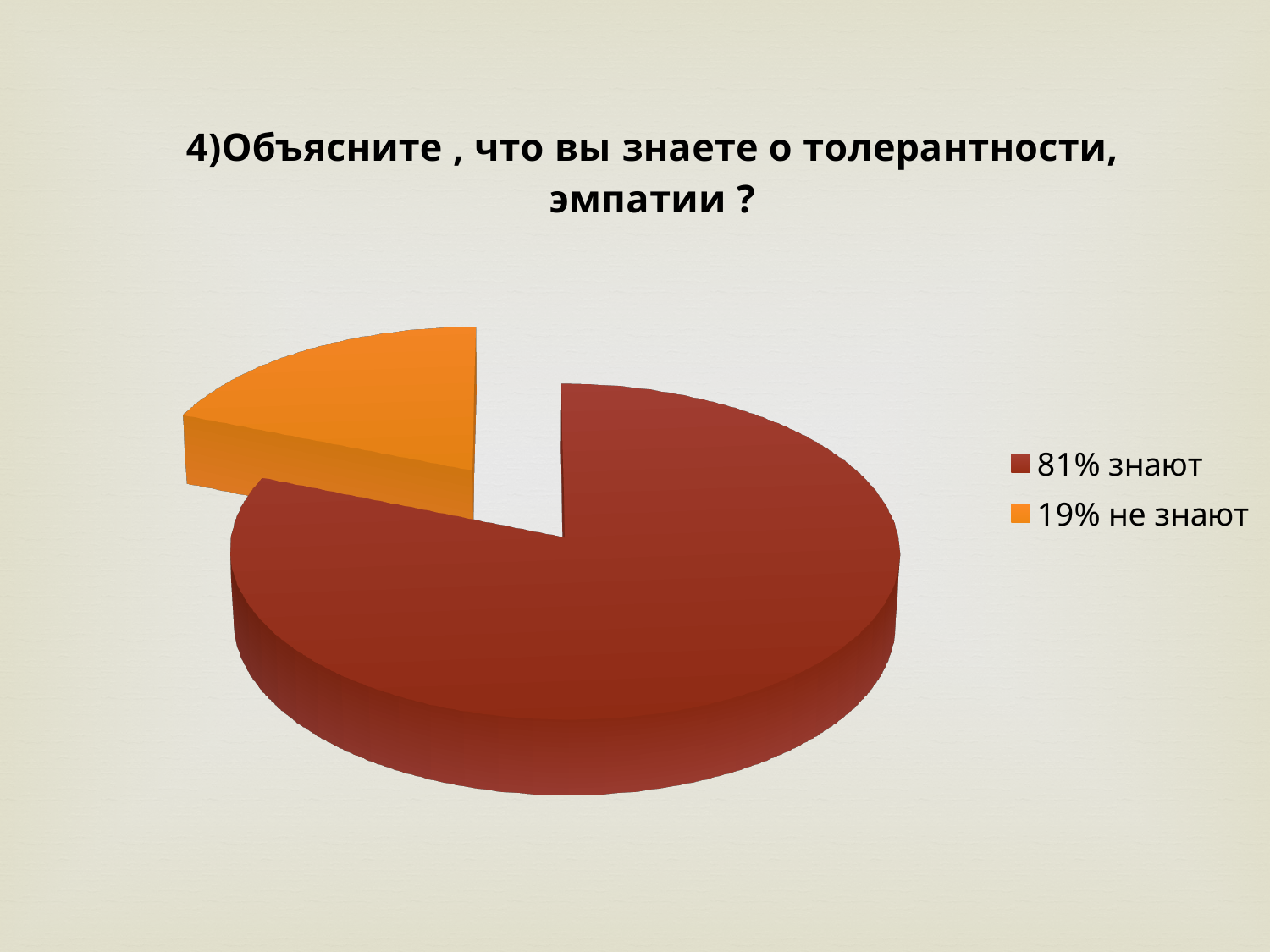
What share of the pie is labelled "знают"? 81% What is the difference in percentage points between the "знают" and "не знают" slices? 62 How many entries does the legend list? 2 Which slice is the smallest? 19% не знают Which is larger: the "знают" slice or the "не знают" slice? знают What colour is the "не знают" slice? orange Which slice is the largest? 81% знают What share of the pie is labelled "не знают"? 19% How many slices does the pie chart have? 2 What is the title of the chart? 4)Объясните , что вы знаете о толерантности, эмпатии ? What kind of chart is shown on the slide? pie chart